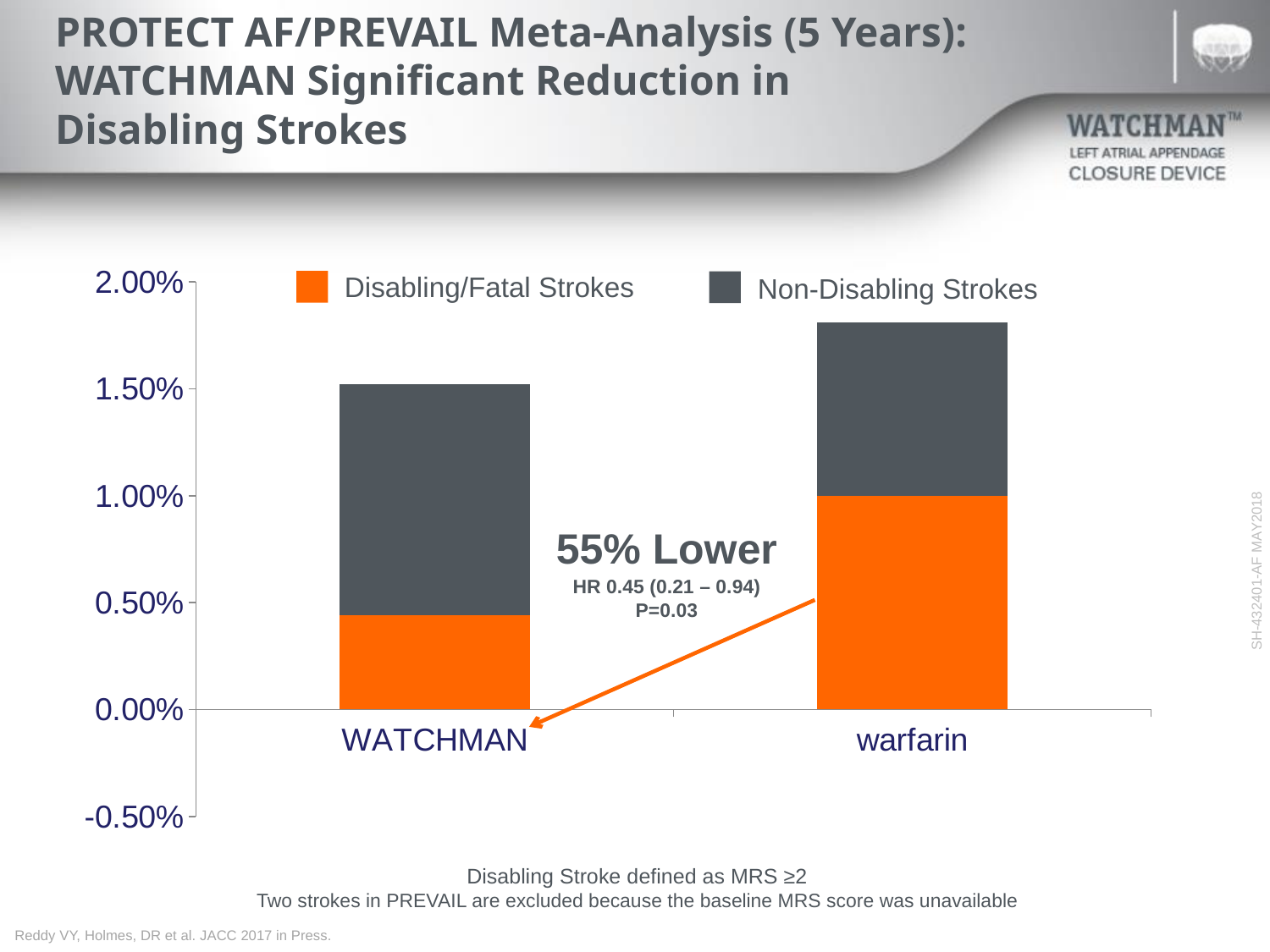
Which series is shown in orange in the chart's legend? Disabling/Fatal Strokes How many categories are shown on the x axis of the chart? 2 What percentage reduction is annotated on the chart between WATCHMAN and warfarin? 55% Lower Is the total value of the warfarin bar greater or less than 2.00%? less Is the total value of the WATCHMAN bar greater or less than 1.00%? greater Which category has the lowest total stroke rate? WATCHMAN Which category has the larger Disabling/Fatal Strokes segment, WATCHMAN or warfarin? warfarin Is the total value of the warfarin bar greater or less than 1.50%? greater How many series does the chart's legend list? 2 What kind of chart is shown on the slide? Stacked bar chart Which category has the taller stacked bar, WATCHMAN or warfarin? warfarin